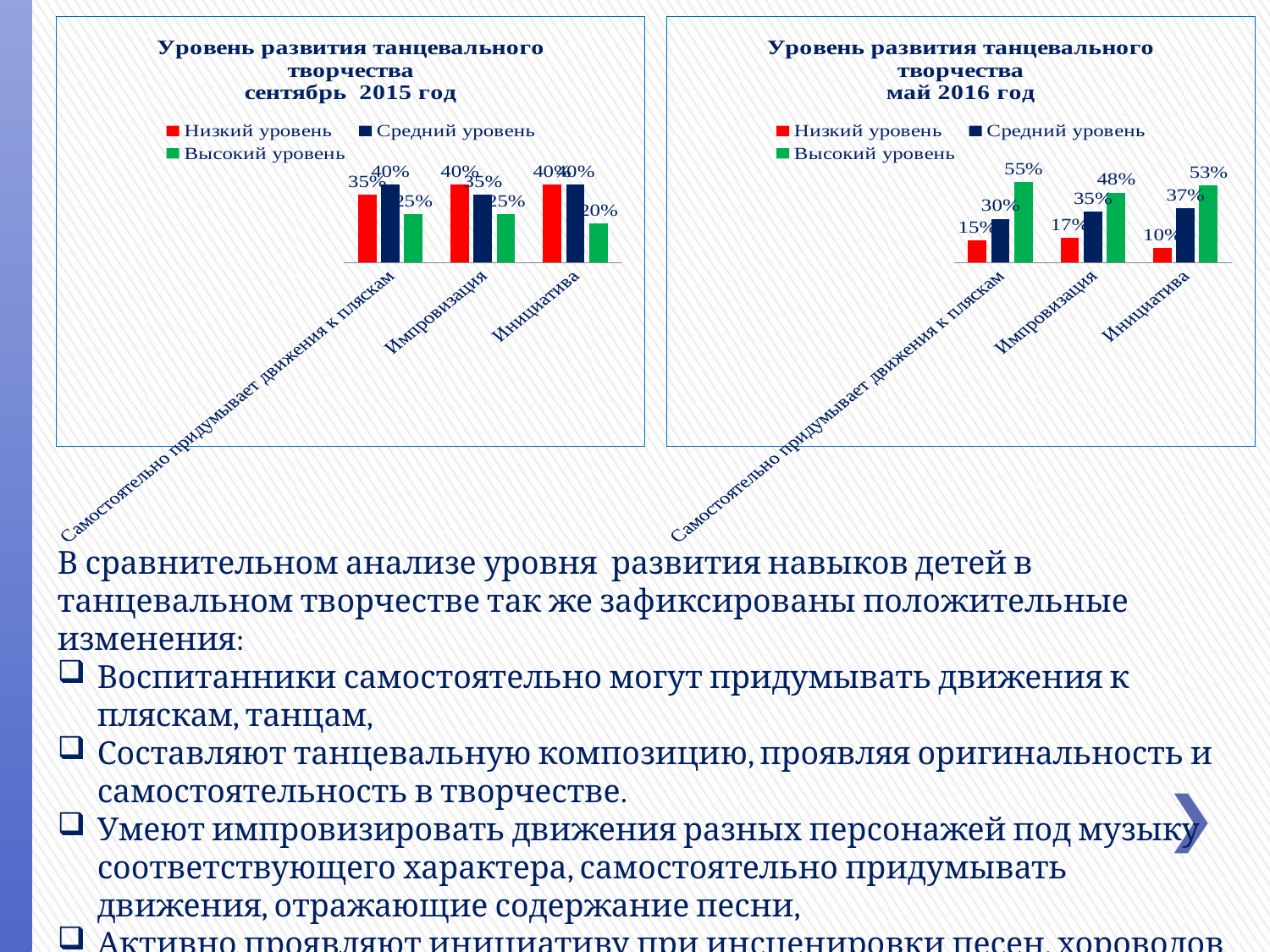
In the chart titled "Уровень развития танцевального творчества сентябрь 2015 год", what is the value of Низкий уровень for Импровизация? 40% In the chart titled "Уровень развития танцевального творчества май 2016 год", what is the difference between Высокий уровень and Низкий уровень for Импровизация? 31% In the chart titled "Уровень развития танцевального творчества май 2016 год", which category has the highest value for Высокий уровень? Самостоятельно придумывает движения к пляскам In the chart titled "Уровень развития танцевального творчества сентябрь 2015 год", what is the difference between Средний уровень and Высокий уровень for Самостоятельно придумывает движения к пляскам? 15% In the chart titled "Уровень развития танцевального творчества май 2016 год", what is the value of Высокий уровень for Инициатива? 53% In the chart titled "Уровень развития танцевального творчества май 2016 год", what is the value of Низкий уровень for Самостоятельно придумывает движения к пляскам? 15% In the chart titled "Уровень развития танцевального творчества май 2016 год", which category has the lowest value for Низкий уровень? Инициатива How many categories are shown on the x axis of the chart titled "Уровень развития танцевального творчества май 2016 год"? 3 In the chart titled "Уровень развития танцевального творчества май 2016 год", which is larger for Инициатива: Средний уровень or Высокий уровень? Высокий уровень How many series does the legend list in the chart titled "Уровень развития танцевального творчества сентябрь 2015 год"? 3 In the chart titled "Уровень развития танцевального творчества сентябрь 2015 год", what is the value of Высокий уровень for Инициатива? 20% What kind of chart is the chart titled "Уровень развития танцевального творчества сентябрь 2015 год"? Bar chart